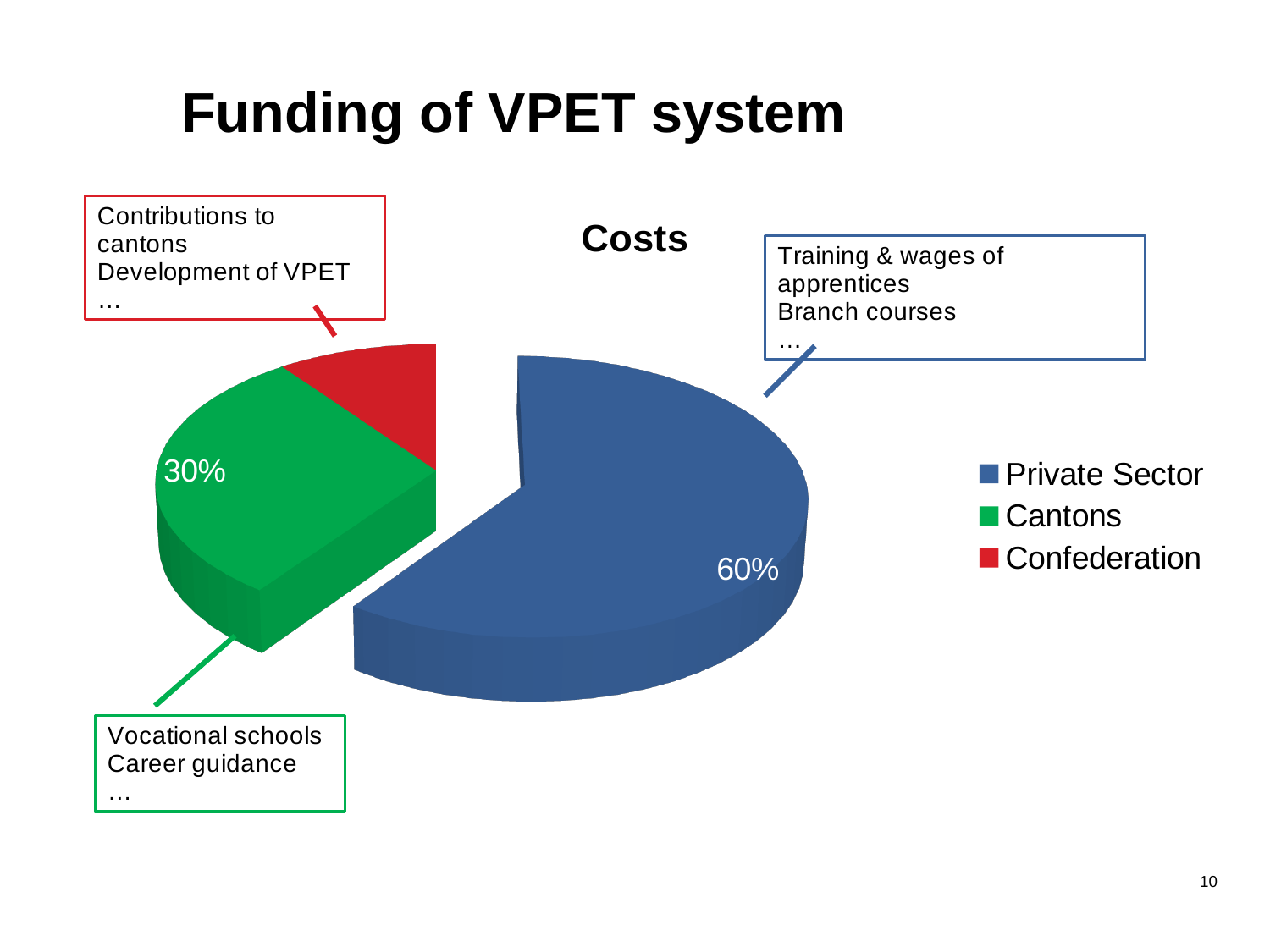
What share of costs is attributed to the Cantons? 30% Which slice is larger, Private Sector or Cantons? Private Sector How many entries does the legend list? 3 Which category has the smallest slice of the pie? Confederation What kind of chart is shown on the slide? Pie chart Which slice is larger, Cantons or Confederation? Cantons Which category has the largest slice of the pie? Private Sector What colour is the Confederation slice? Red What is the title of the chart? Costs By how many percentage points does the Private Sector share exceed the Cantons share? 30 percentage points What share of costs is attributed to the Private Sector? 60% How many slices does the pie chart have? 3